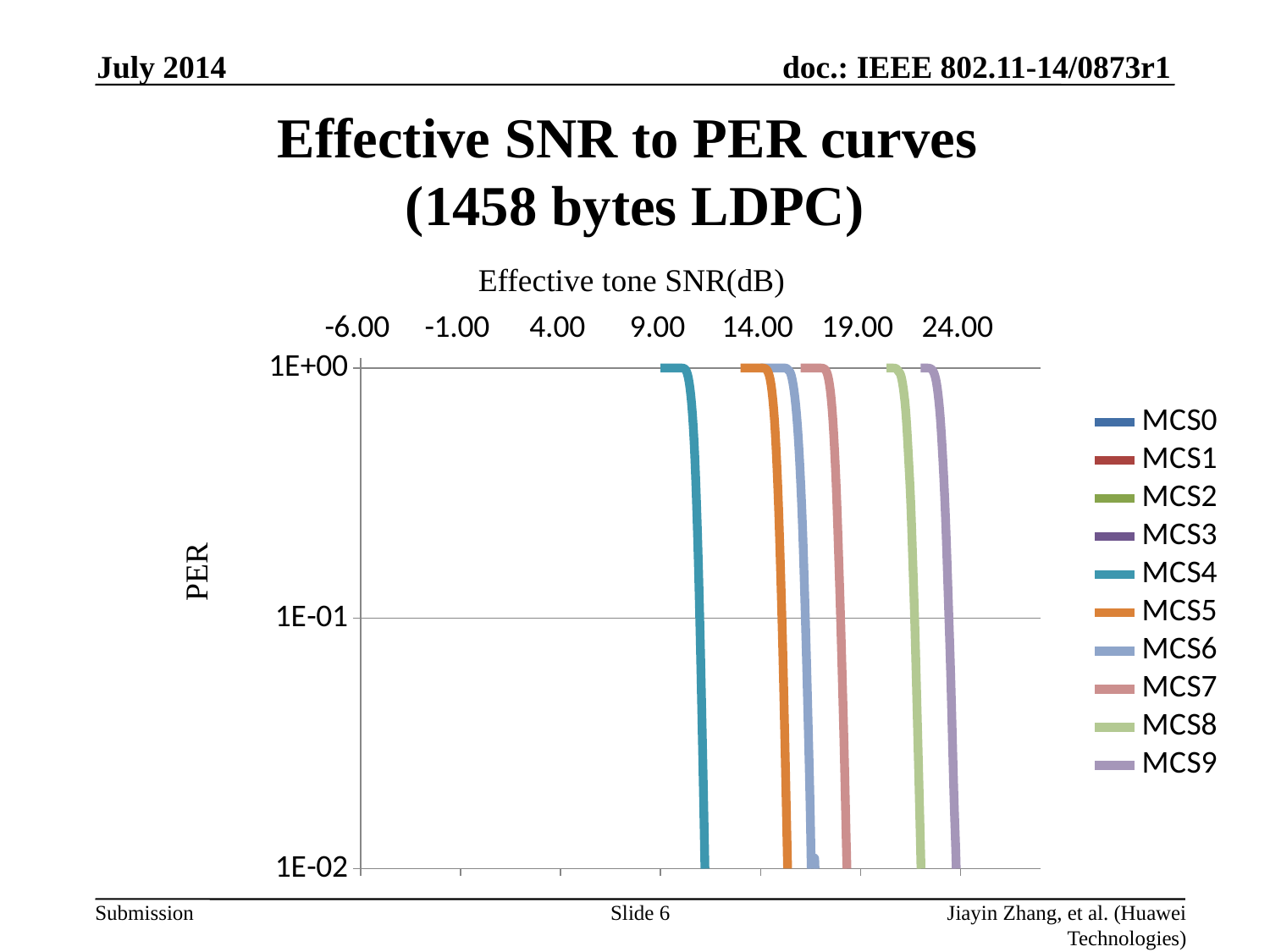
Is the SNR at which the MCS4 curve reaches a PER of 1E-01 greater or less than 14.00? less What kind of chart is shown on the slide? line chart Is the SNR at which the MCS7 curve reaches a PER of 1E-01 greater or less than 19.00? less Which curve requires a lower SNR to reach a PER of 1E-01, MCS4 or MCS6? MCS4 Which visible curve is furthest to the left (lowest SNR)? MCS4 How many series does the legend list? 10 Which curve requires a higher SNR to reach a PER of 1E-01, MCS7 or MCS8? MCS8 Is the SNR at which the MCS9 curve reaches a PER of 1E-01 greater or less than 19.00? greater Which series has its curve furthest to the right (highest SNR)? MCS9 As the effective tone SNR increases along each curve, does the PER rise or fall? fall What is the title of the chart? Effective SNR to PER curves (1458 bytes LDPC) What is the label of the horizontal axis? Effective tone SNR(dB)